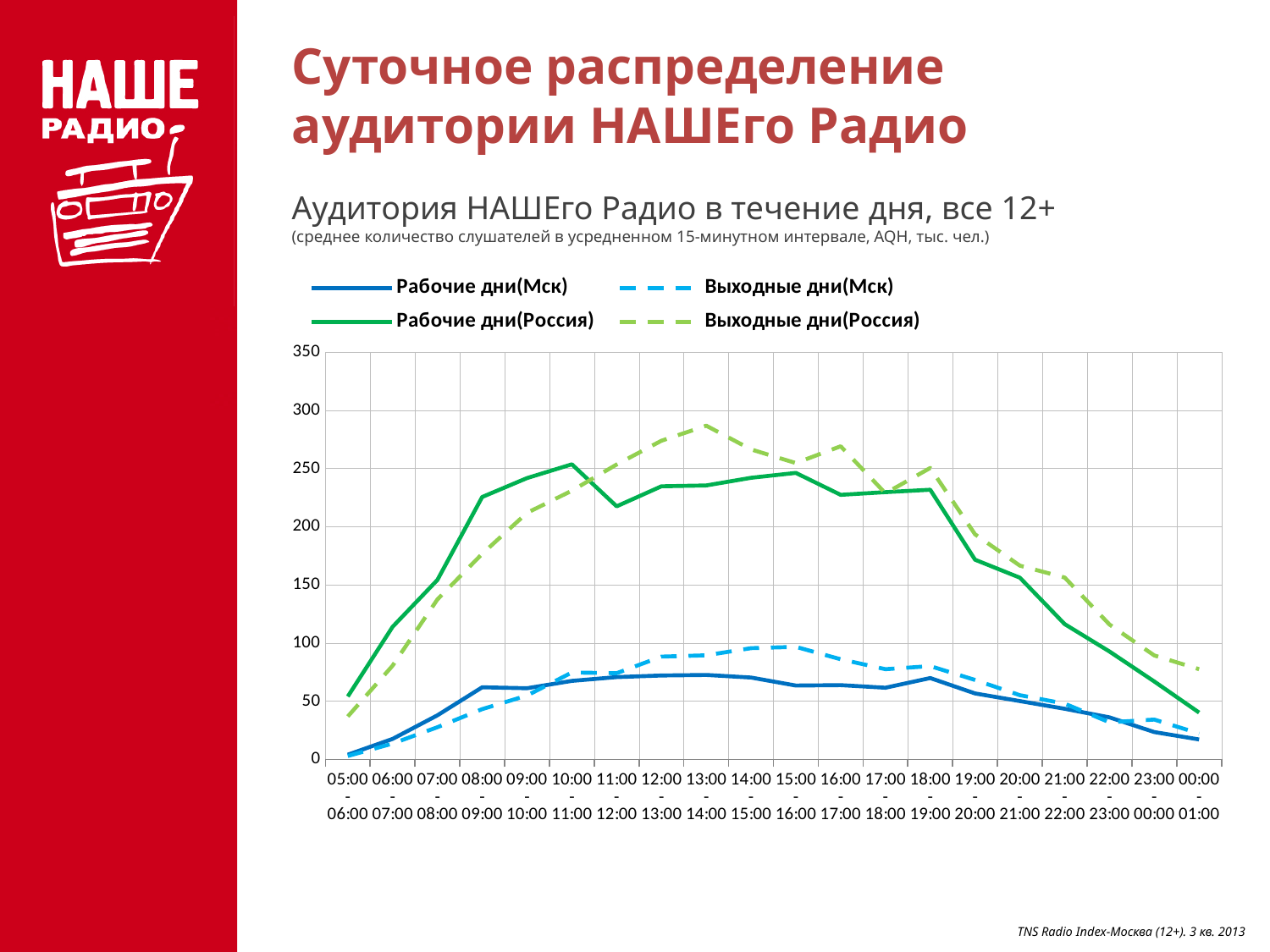
How many series does the legend list? 4 Which series reaches the highest value on the chart? Выходные дни(Россия) What is the title of the chart? Аудитория НАШЕго Радио в течение дня, все 12+ In which time interval does the Выходные дни(Россия) series reach its peak? 13:00-14:00 In which time interval is the Рабочие дни(Мск) series lowest? 05:00-06:00 Is the value for Рабочие дни(Россия) at 00:00-01:00 greater or less than 50? less Is the value for Рабочие дни(Мск) at 13:00-14:00 greater or less than 100? less How many time intervals are plotted along the x axis? 20 At 13:00-14:00, which is higher: Рабочие дни(Россия) or Выходные дни(Россия)? Выходные дни(Россия) What kind of chart is shown on the slide? line chart Does the Рабочие дни(Россия) series rise or fall from 18:00-19:00 to 00:00-01:00? fall Is the value for Выходные дни(Россия) at 13:00-14:00 greater or less than 250? greater